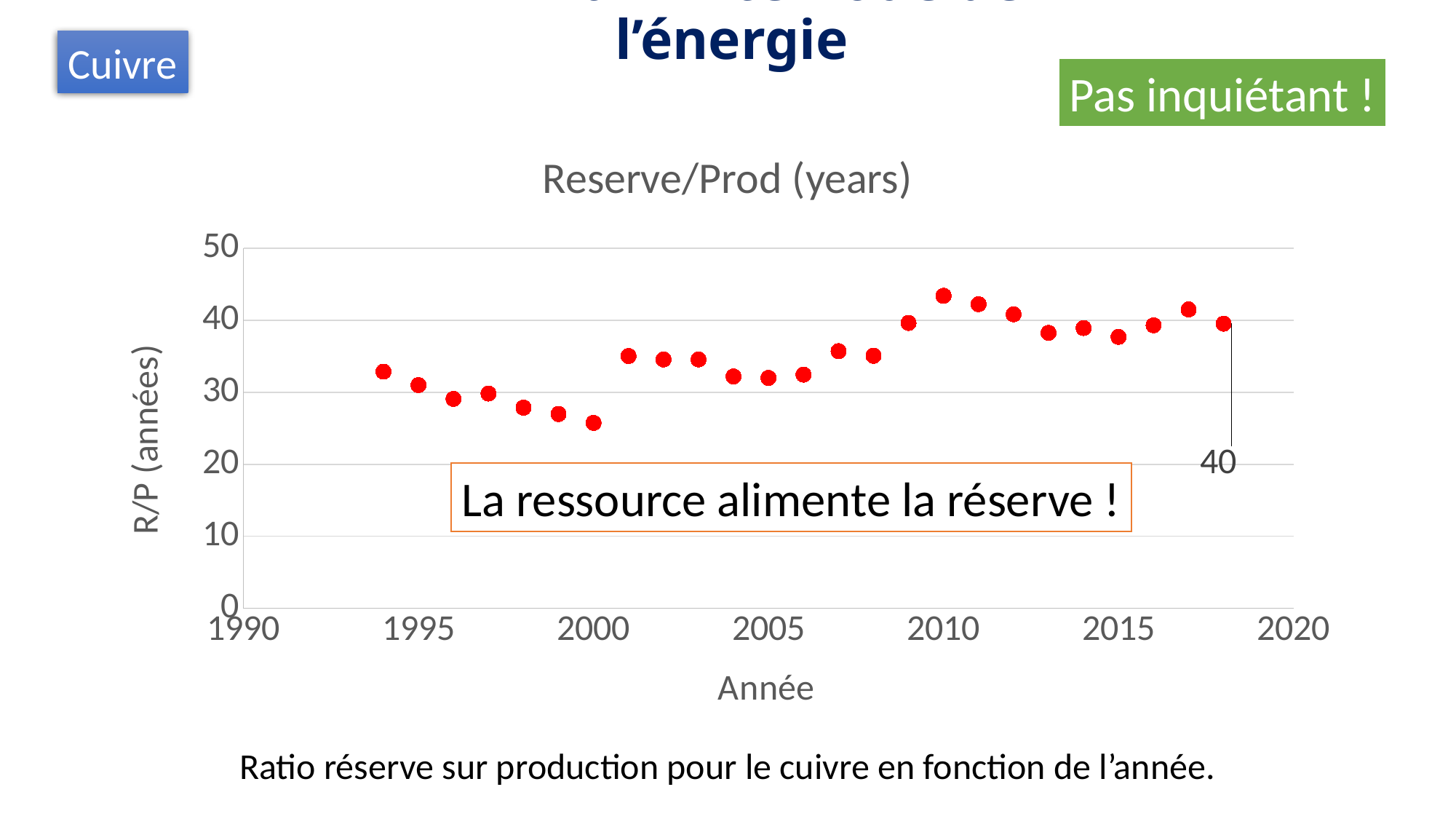
Which year has the larger value, 2010 or 2000? 2010 What kind of chart is shown on the slide? scatter chart Is the value for 2005 greater or less than 30? greater Which year has the larger value, 1994 or 2000? 1994 Do the values rise or fall from 1994 to 2000? fall How many data points are plotted on the chart? 25 Which year has the highest Reserve/Prod value? 2010 What is the data label shown for the year 2018? 40 What is the title of the chart? Reserve/Prod (years) Is the value for 2010 greater or less than 40? greater Which year has the lowest Reserve/Prod value? 2000 Is the value for 2000 greater or less than 30? less